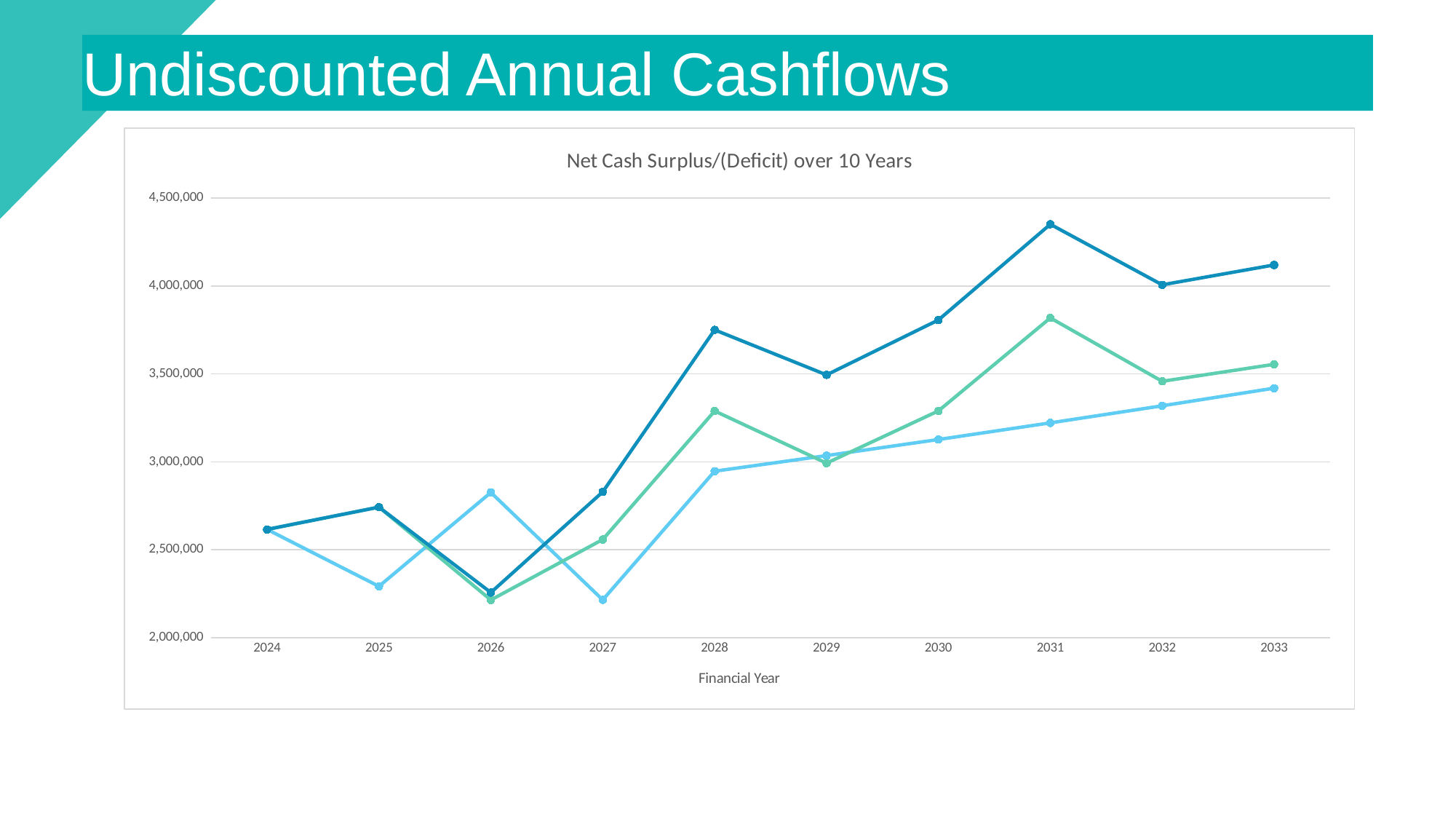
Is the value of the dark blue line in 2031 greater or less than 4,000,000? greater Is the value of the light blue line in 2025 greater or less than 2,500,000? less What is the label on the x axis of the chart? Financial Year In which year does the green line reach its lowest value? 2026 What type of chart is shown on the slide? Line chart How many financial years are shown on the x axis? 10 What is the title of the chart? Net Cash Surplus/(Deficit) over 10 Years How many lines are plotted on the chart? 3 In 2028, which line has the higher value, the dark blue line or the green line? The dark blue line In which year does the dark blue line reach its highest value? 2031 Does the dark blue line rise or fall between 2029 and 2031? Rises Is the value of the green line in 2031 greater or less than 3,500,000? greater